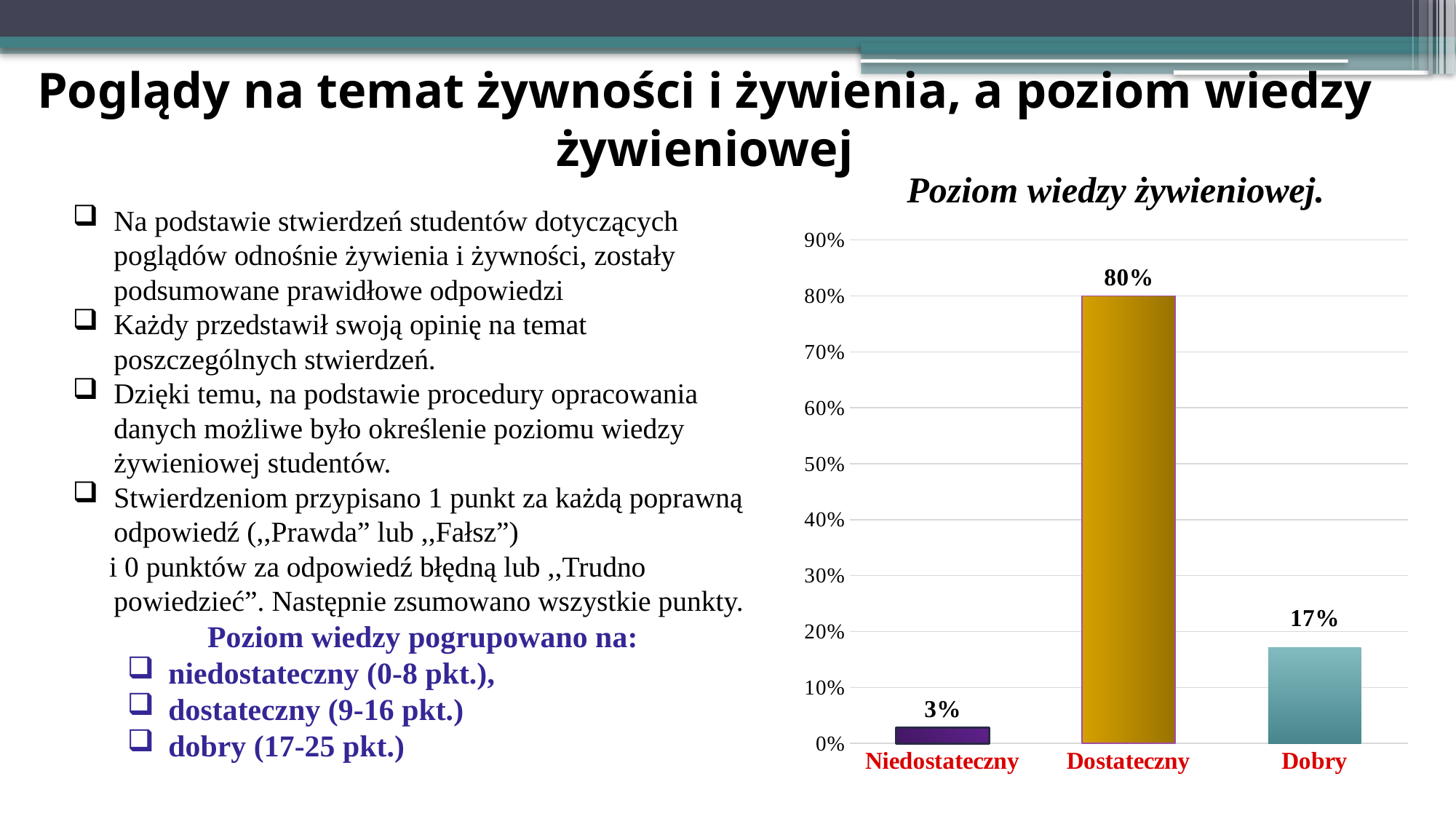
Which category has the lowest value? Niedostateczny What is the value for Dobry? 17% Which is larger, the value for Dobry or the value for Niedostateczny? Dobry What is the value for Dostateczny? 80% Which category has the highest value? Dostateczny What kind of chart is shown on the slide? bar chart How many categories are shown on the x axis? 3 What is the value for Niedostateczny? 3% What is the difference between the values for Dobry and Niedostateczny? 14% What is the difference between the values for Dostateczny and Dobry? 63% What is the title of the chart? Poziom wiedzy żywieniowej. Is the value for Dobry greater or less than 20%? less